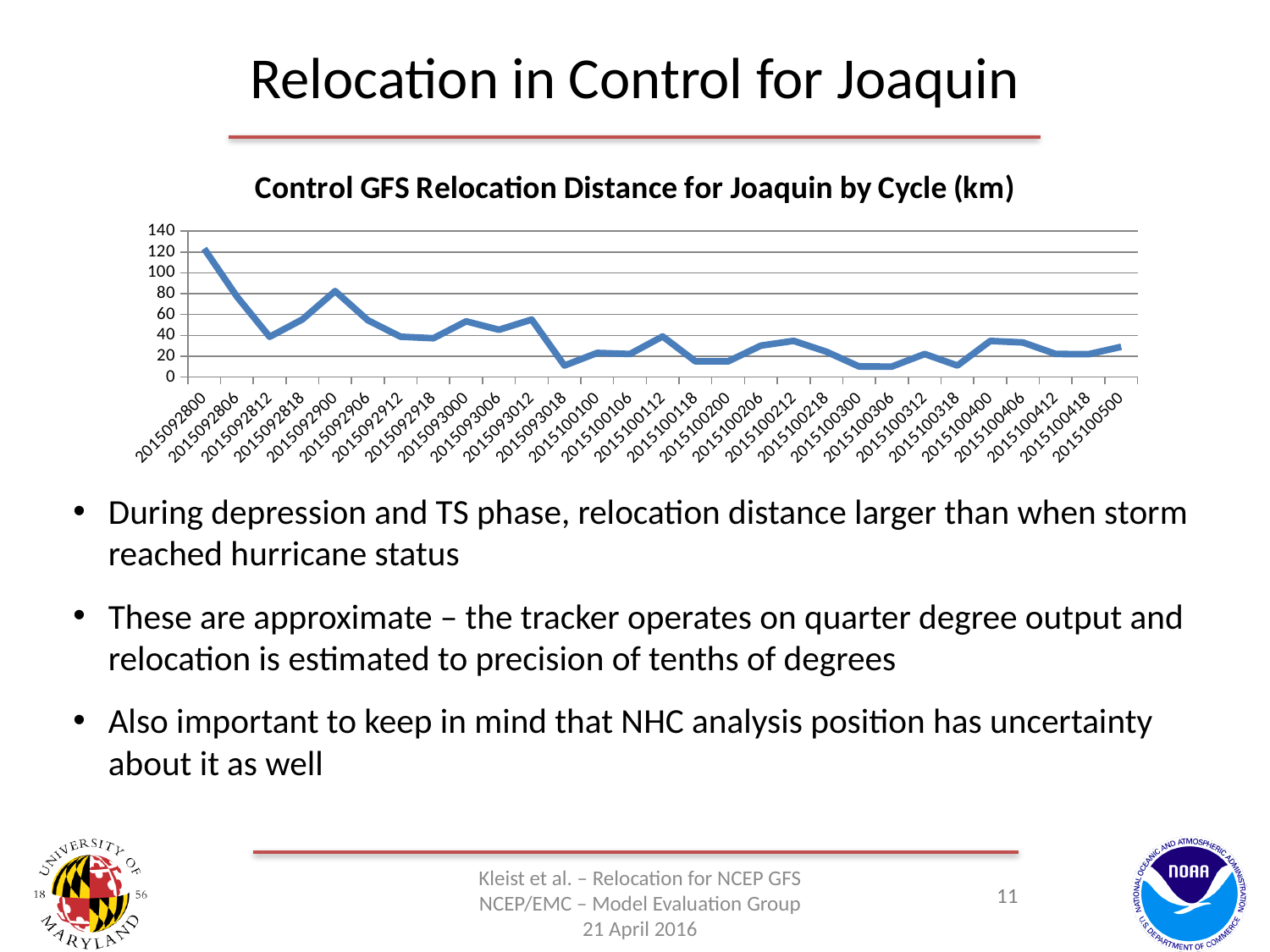
Is the value for 2015092800 greater or less than 100? greater Is the value for 2015092812 greater or less than 60? less Which is larger, the value for 2015092800 or the value for 2015092900? 2015092800 Overall, do the relocation distances rise or fall from the first cycle to the last cycle? fall How many cycles are plotted along the x axis? 29 What is the title of the chart? Control GFS Relocation Distance for Joaquin by Cycle (km) Which cycle has the highest relocation distance? 2015092800 Is the value for 2015100300 greater or less than 20? less What kind of chart is shown on the slide? line chart